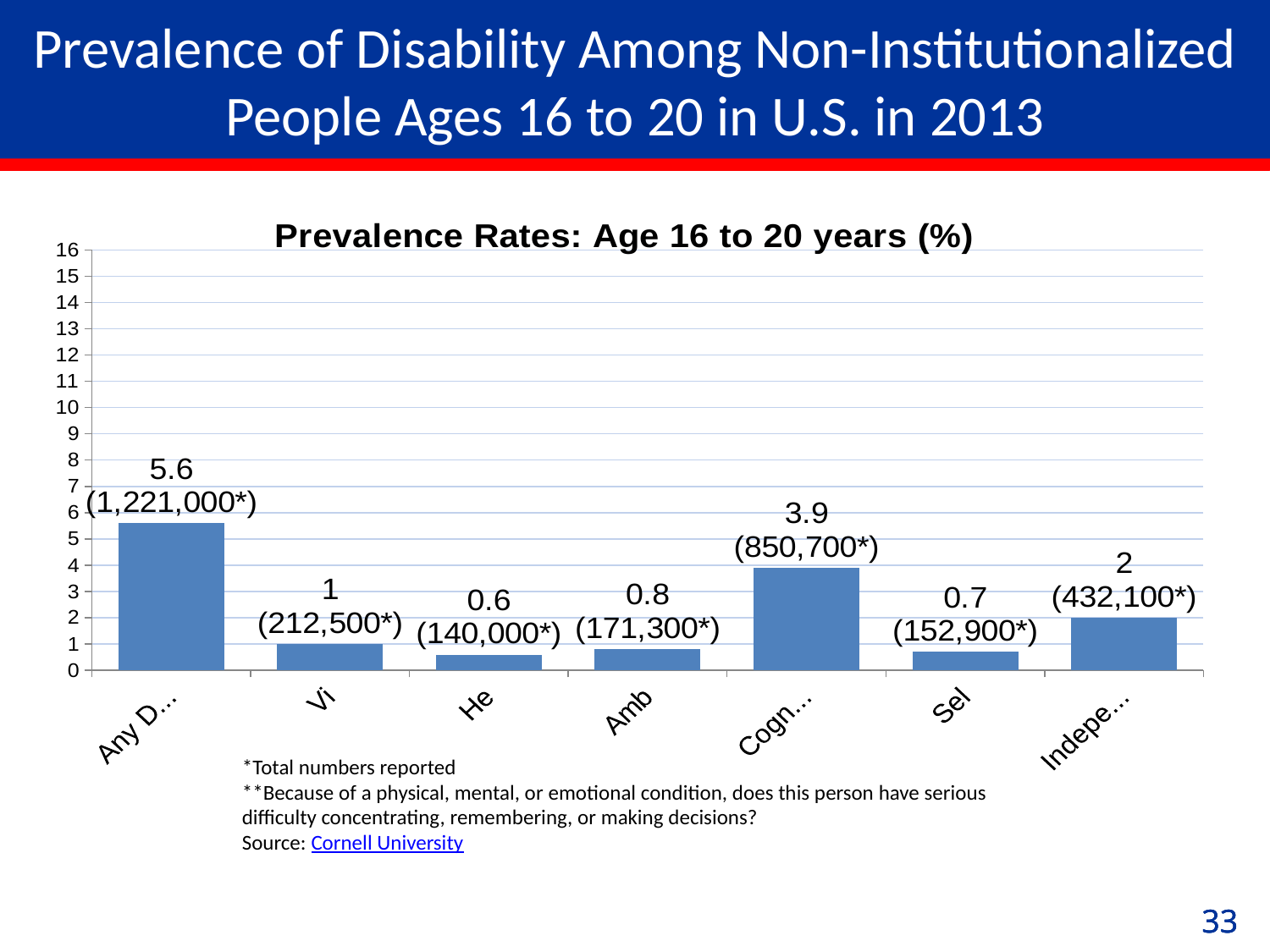
Is the value of the rightmost bar greater or less than 3? less What total number is reported in parentheses for the third bar, which has a value of 0.6? (140,000*) Which bar has the lowest value in the chart? the third bar, 0.6 What is the difference between the first bar (5.6) and the fifth bar (3.9)? 1.7 Which bar has the highest value in the chart? the first (leftmost) bar, 5.6 How many bars are plotted in the chart? 7 What is the value of the last (rightmost) bar in the chart? 2 What is the value of the first (leftmost) bar in the chart? 5.6 What is the value of the fifth bar, labeled with the total (850,700*)? 3.9 Which is larger: the fourth bar (0.8) or the sixth bar (0.7)? the fourth bar (0.8) What is the title of the chart? Prevalence Rates: Age 16 to 20 years (%) What type of chart is shown on the slide? bar chart